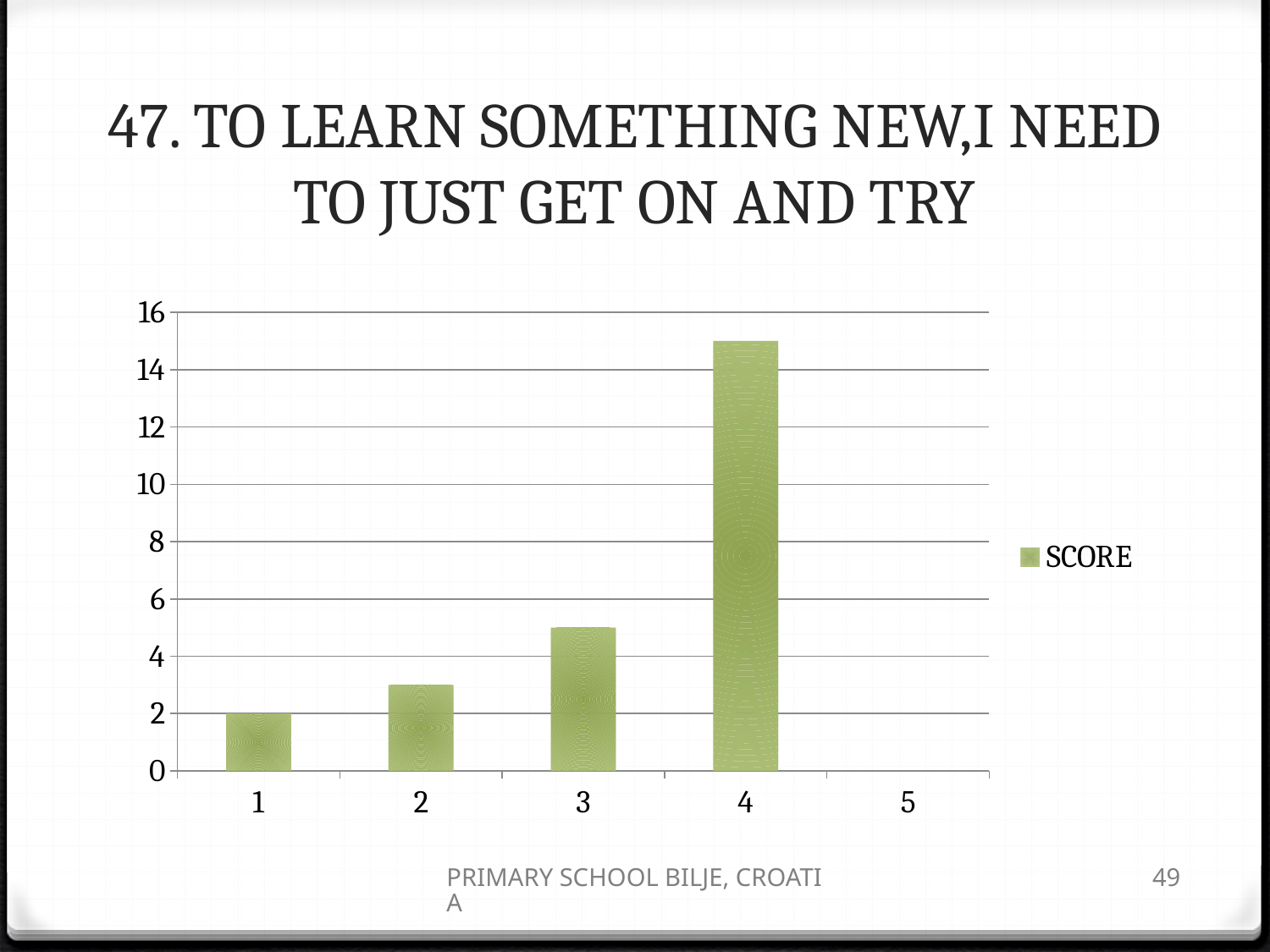
Which has a larger SCORE value, category 2 or category 3? 3 What is the name of the series shown in the legend? SCORE Is the SCORE value for category 4 greater or less than 14? greater How many series does the chart's legend list? 1 What kind of chart is shown on the slide? bar chart How many categories are shown on the x axis of the chart? 5 What is the SCORE value for category 5? 0 Is the SCORE value for category 3 greater or less than 4? greater What is the SCORE value for category 1? 2 Which category has the lowest SCORE value? 5 Is the SCORE value for category 2 greater or less than 4? less Which category has the highest SCORE value? 4